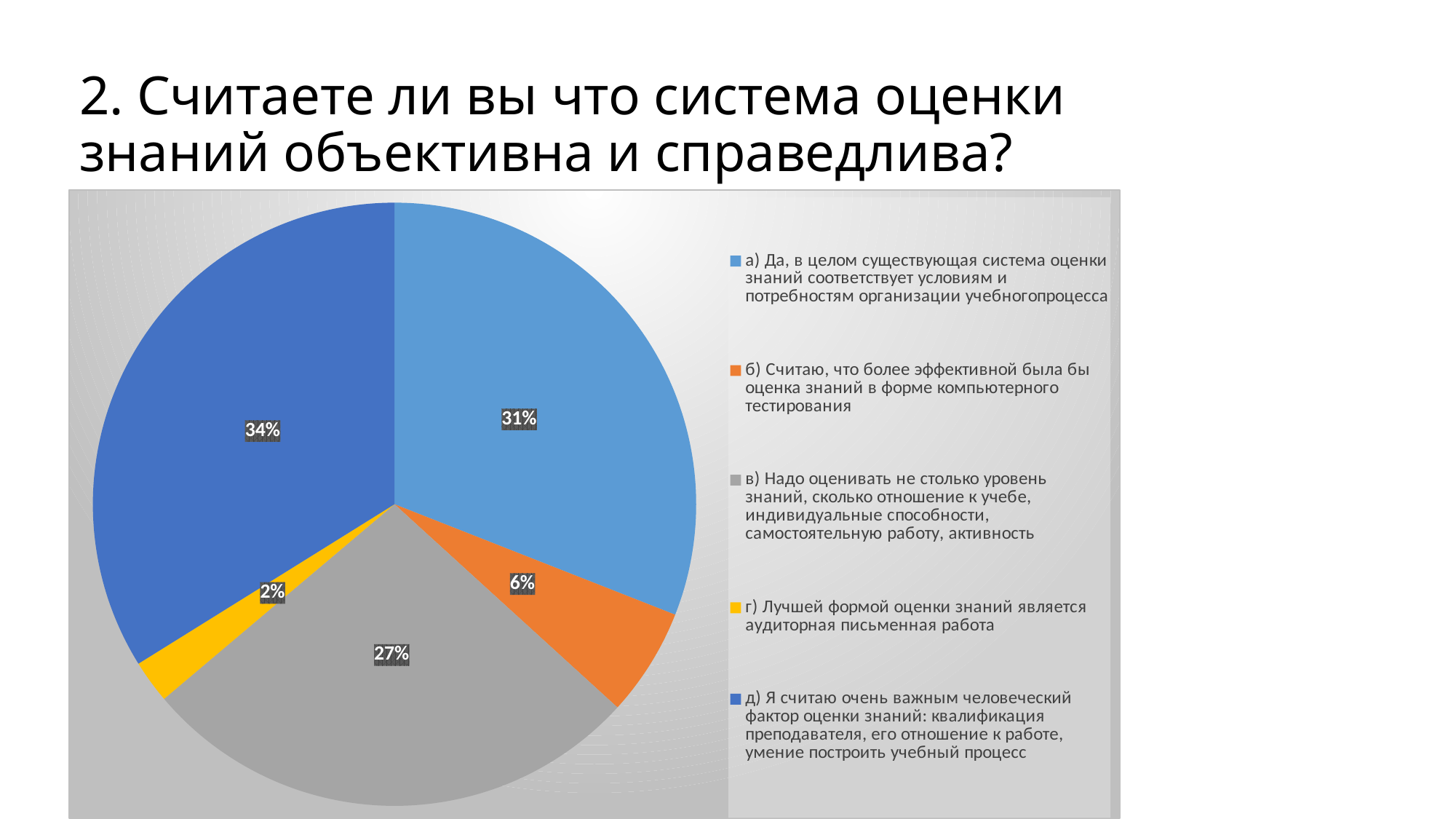
What share of the pie does option г) (аудиторная письменная работа) have? 2% What share of the pie does option б) (оценка знаний в форме компьютерного тестирования) have? 6% What is the difference in percentage points between option д) (34%) and option а) (31%)? 3% What share of the pie does option в) (Надо оценивать не столько уровень знаний, сколько отношение к учебе...) have? 27% What kind of chart is shown on the slide? pie chart How many slices does the pie chart have? 5 Which option has the largest share of the pie? д) Я считаю очень важным человеческий фактор оценки знаний Which has a larger share: option в) or option б)? в) Надо оценивать не столько уровень знаний, сколько отношение к учебе Which option has the smallest share of the pie? г) Лучшей формой оценки знаний является аудиторная письменная работа What colour is the slice for option г) (аудиторная письменная работа)? yellow